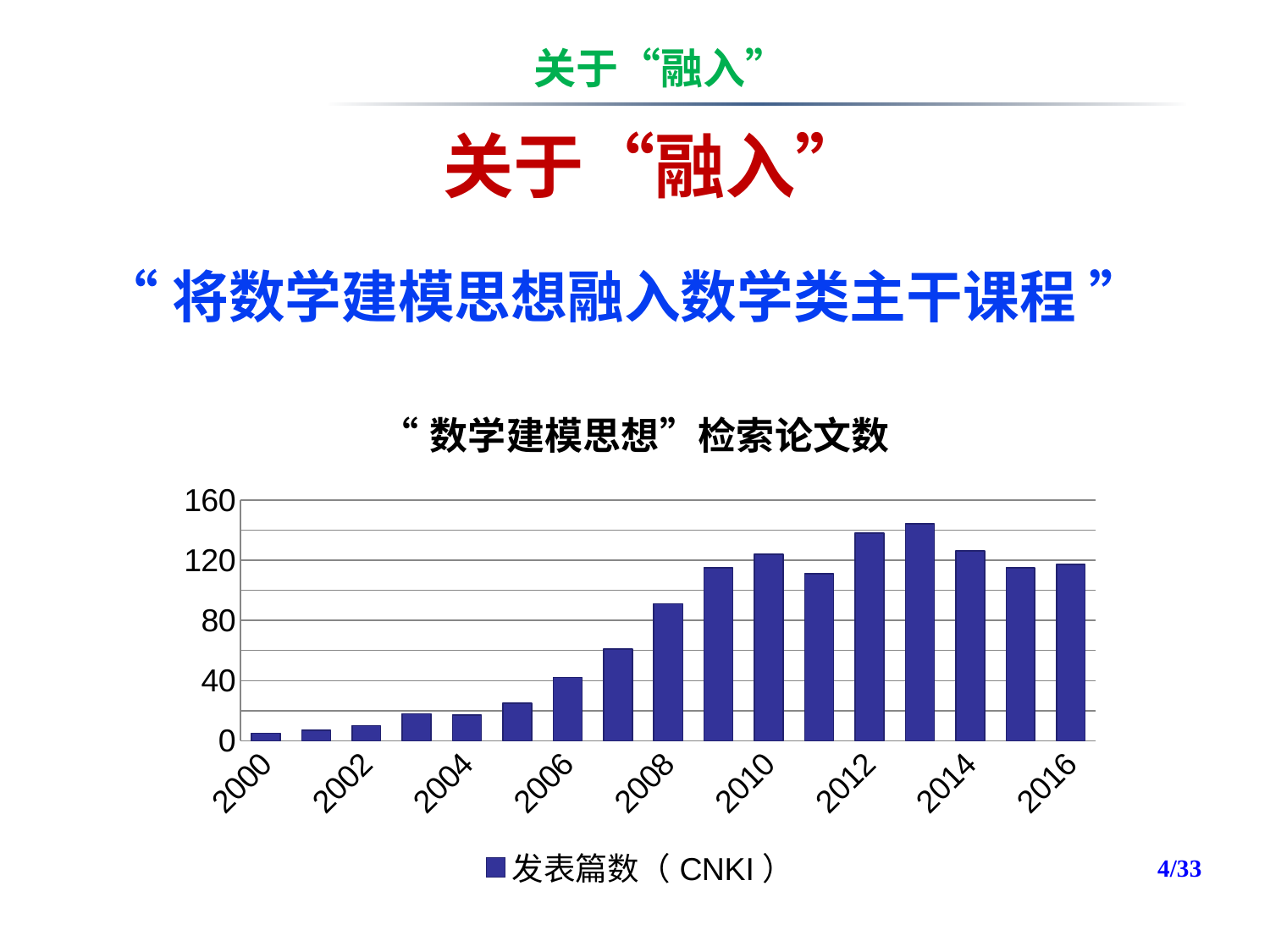
Is the value for 2008 greater or less than 80? greater Which year has the lowest number of papers in the chart? 2000 Which year has the highest number of papers in the chart? 2013 Is the value for 2013 greater or less than 120? greater Is the value for 2007 greater or less than 80? less Which year has a larger value, 2012 or 2011? 2012 What kind of chart is shown on the slide? bar chart Which year has a larger value, 2008 or 2007? 2008 How many series does the legend list? 1 How many years (bars) are plotted in the chart? 17